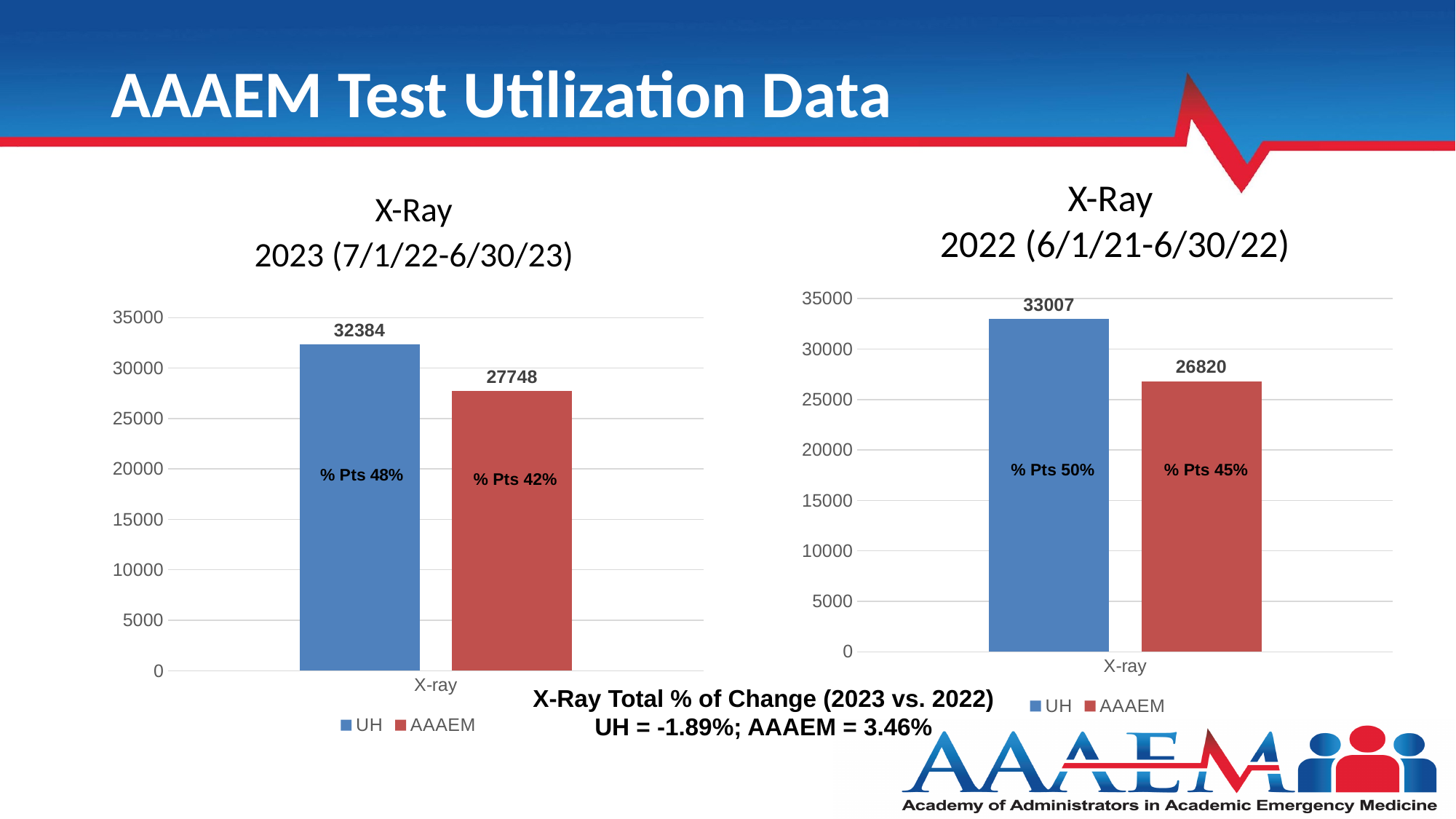
In the X-Ray 2022 (6/1/21-6/30/22) chart, what is the value for UH? 33007 What kind of chart is the X-Ray 2022 (6/1/21-6/30/22) chart? Bar chart In the X-Ray 2022 (6/1/21-6/30/22) chart, what is the difference between the UH and AAAEM values? 6187 In the X-Ray 2023 (7/1/22-6/30/23) chart, what % Pts label is shown on the AAAEM bar? % Pts 42% In the X-Ray 2023 (7/1/22-6/30/23) chart, what is the value for AAAEM? 27748 In the X-Ray 2023 (7/1/22-6/30/23) chart, which series has the higher value, UH or AAAEM? UH In the X-Ray 2022 (6/1/21-6/30/22) chart, what is the value for AAAEM? 26820 In the X-Ray 2022 (6/1/21-6/30/22) chart, which series has the lowest value? AAAEM How many series does the legend of the X-Ray 2023 (7/1/22-6/30/23) chart list? 2 In the X-Ray 2023 (7/1/22-6/30/23) chart, what is the difference between the UH and AAAEM values? 4636 In the X-Ray 2022 (6/1/21-6/30/22) chart, what % Pts label is shown on the UH bar? % Pts 50% In the X-Ray 2023 (7/1/22-6/30/23) chart, what is the value for UH? 32384